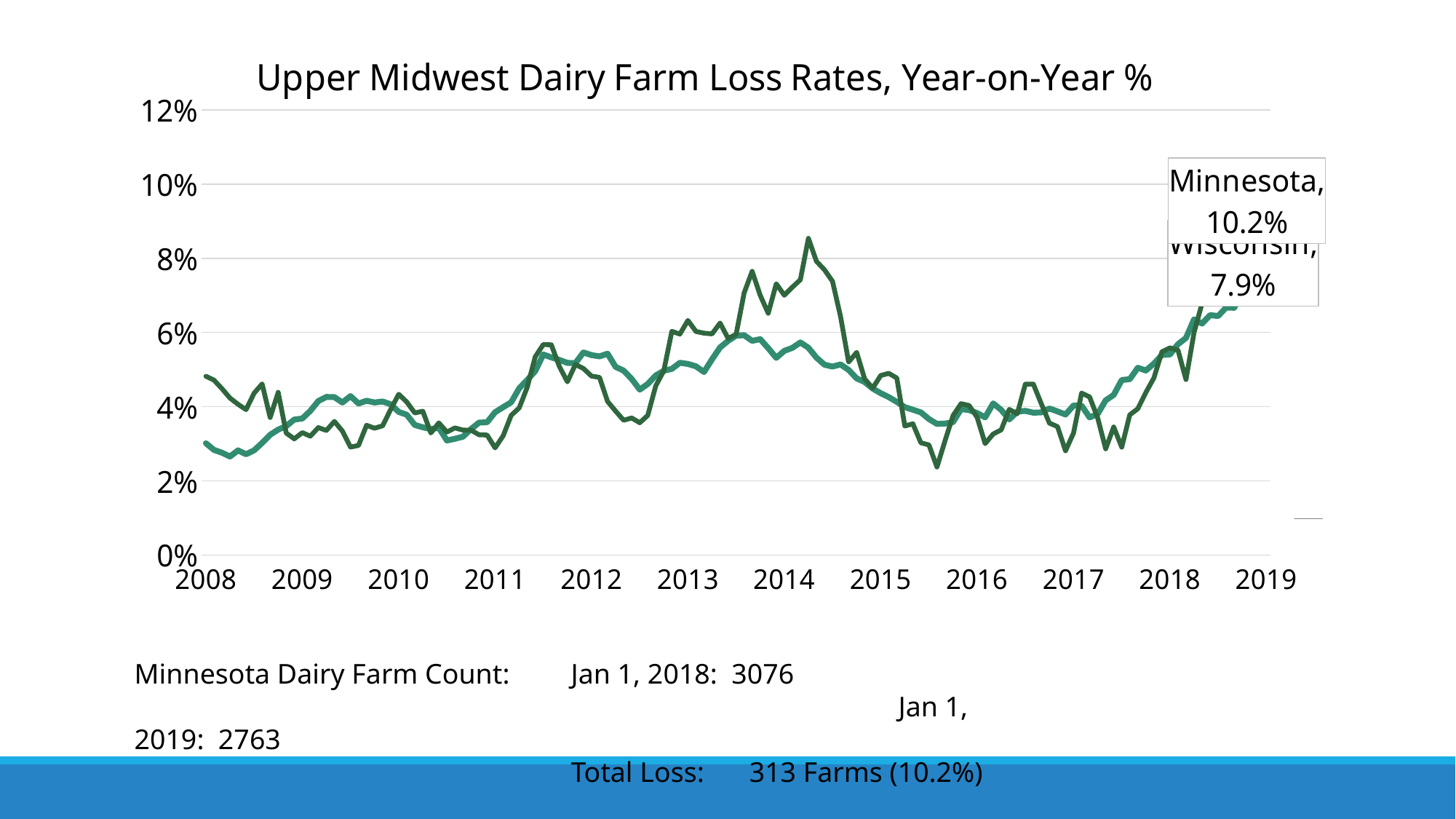
What is the highest value shown on the y axis? 12% How many year labels are shown on the x axis? 12 What kind of chart is shown on the slide? line chart What is the labelled loss rate for Wisconsin at the end of the series? 7.9% Is the labelled end value for Wisconsin greater or less than 8%? less What is the title of the chart? Upper Midwest Dairy Farm Loss Rates, Year-on-Year % What is the difference between the labelled end values for Minnesota (10.2%) and Wisconsin (7.9%)? 2.3 percentage points How many series are plotted on the chart? 2 Between 2017 and 2019, do the loss rates for both states generally rise or fall? rise Is the labelled end value for Minnesota greater or less than 10%? greater What is the labelled loss rate for Minnesota at the end of the series? 10.2% Which state has the higher labelled loss rate at the end of the series, Minnesota or Wisconsin? Minnesota